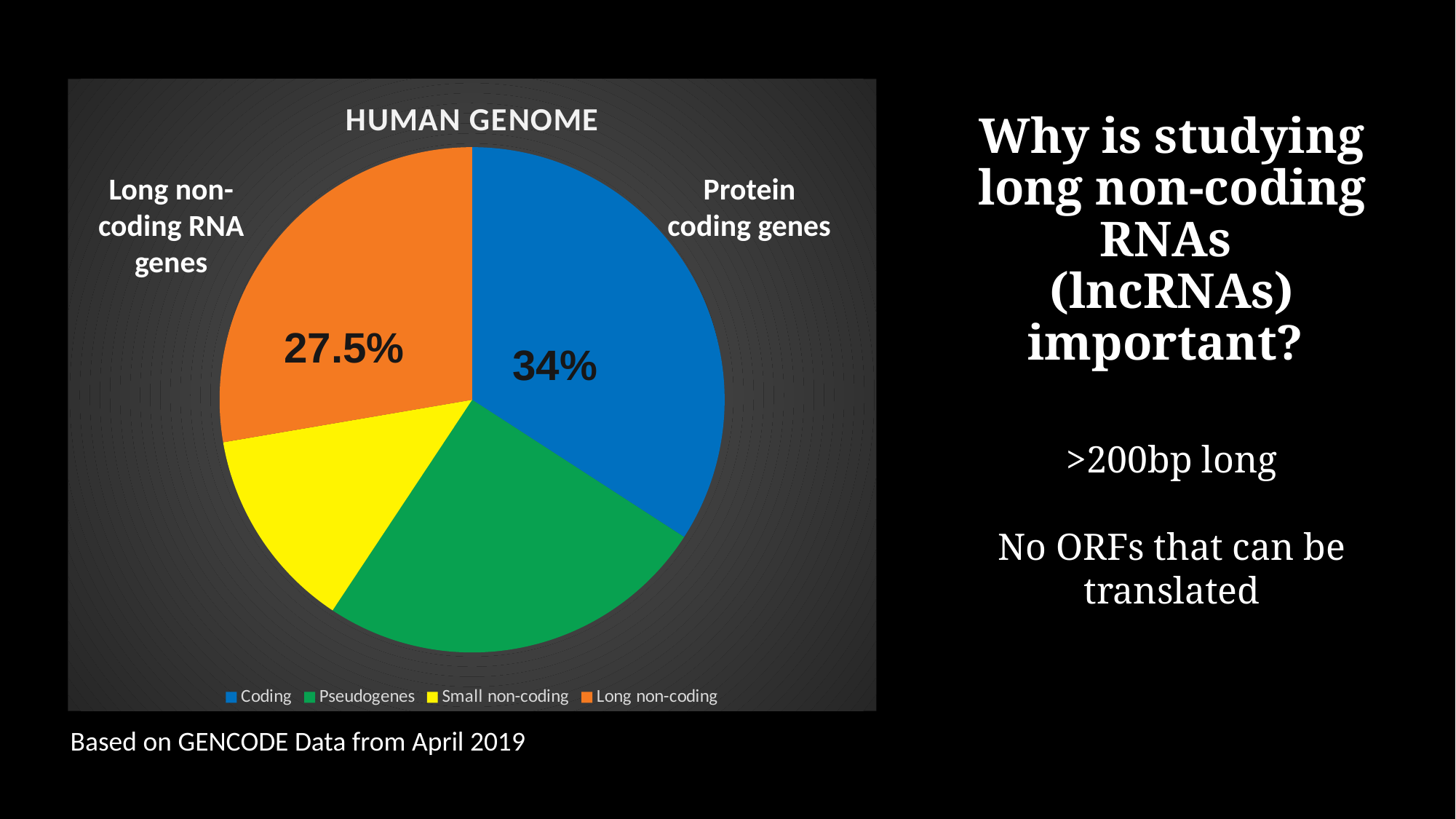
What is the title of the chart? HUMAN GENOME How many entries does the legend list? 4 What percentage of the pie is labelled for Long non-coding RNA genes? 27.5% Which category has the largest slice of the pie? Coding Which category has the smallest slice of the pie? Small non-coding Which slice is larger, Pseudogenes or Small non-coding? Pseudogenes Which slice is larger, Coding or Long non-coding? Coding What colour represents Long non-coding in the pie chart? Orange What is the difference in percentage points between the Coding slice and the Long non-coding slice? 6.5 How many slices does the pie chart have? 4 What type of chart is shown on the slide? Pie chart What percentage of the pie is labelled for Coding (protein coding genes)? 34%